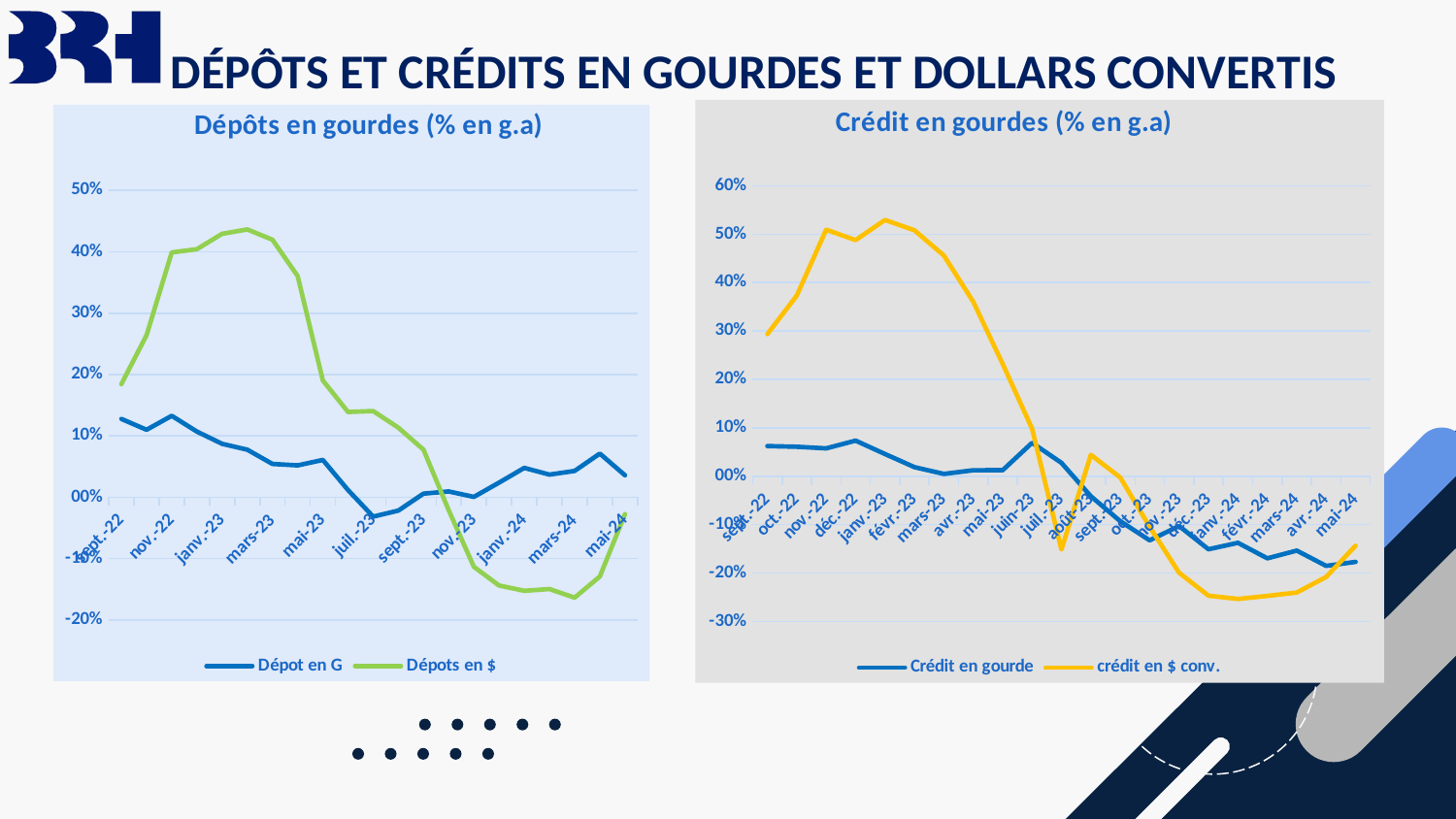
In the 'Dépôts en gourdes (% en g.a)' chart, is the value of 'Dépots en $' for janv.-24 greater or less than -10%? less In the 'Crédit en gourdes (% en g.a)' chart, which colour is the 'crédit en $ conv.' line? yellow In the 'Crédit en gourdes (% en g.a)' chart, is the value of 'crédit en $ conv.' for janv.-23 greater or less than 50%? greater What are the two legend entries of the 'Dépôts en gourdes (% en g.a)' chart? Dépot en G and Dépots en $ How many month labels are shown on the x axis of the 'Crédit en gourdes (% en g.a)' chart? 21 What kind of chart is the 'Dépôts en gourdes (% en g.a)' chart on the left? line chart In the 'Crédit en gourdes (% en g.a)' chart, which series has the higher value at sept.-22, 'Crédit en gourde' or 'crédit en $ conv.'? crédit en $ conv. In the 'Dépôts en gourdes (% en g.a)' chart, which series has the higher value at sept.-22, 'Dépot en G' or 'Dépots en $'? Dépots en $ In the 'Crédit en gourdes (% en g.a)' chart, does the 'Crédit en gourde' line overall rise or fall from sept.-22 to mai-24? fall In the 'Dépôts en gourdes (% en g.a)' chart, is the value of 'Dépots en $' for nov.-22 greater or less than 20%? greater How many series does the legend of the 'Crédit en gourdes (% en g.a)' chart list? 2